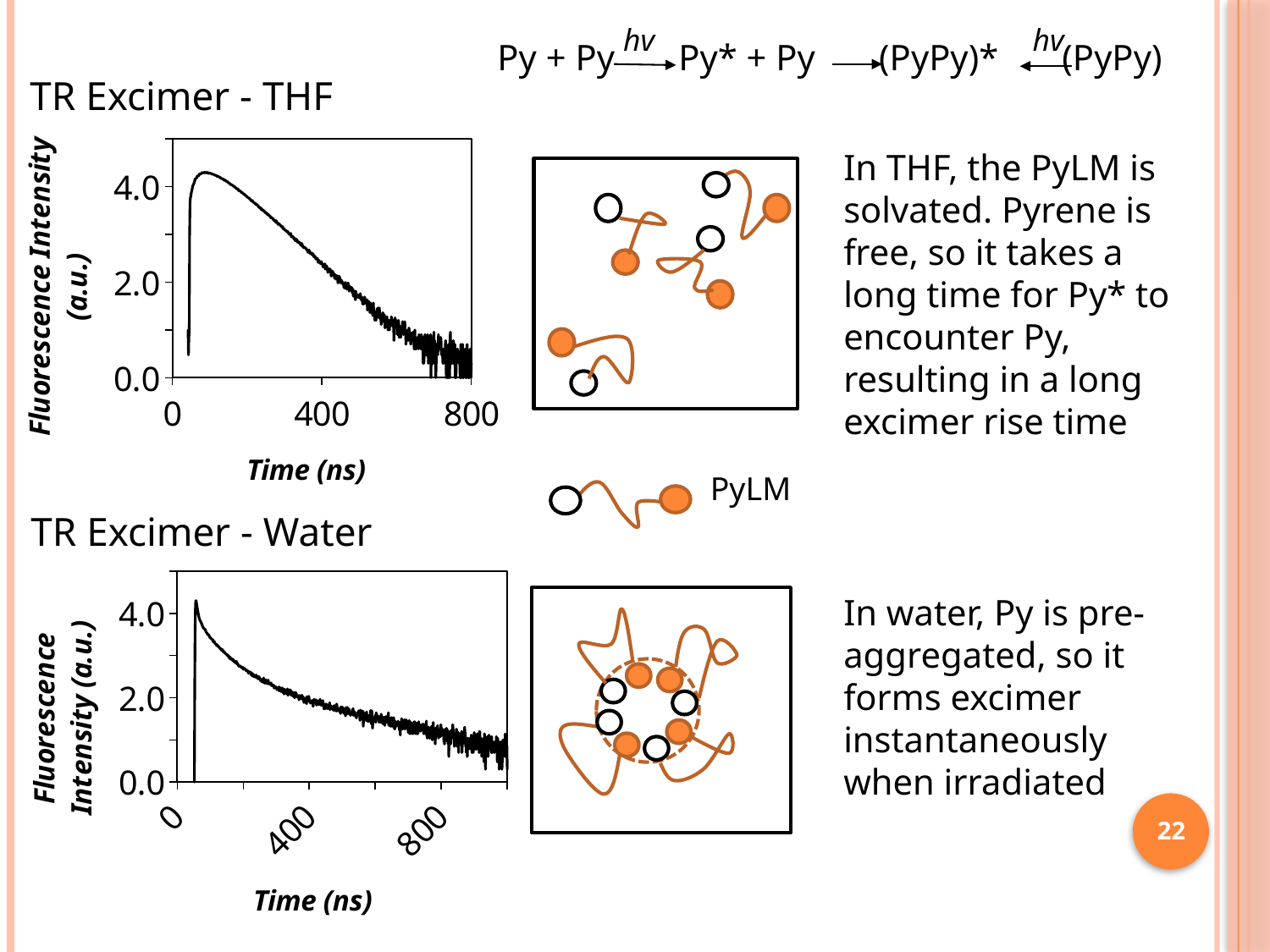
In the TR Excimer - THF chart, is the peak fluorescence intensity greater or less than 2.0? greater What is the x-axis label of the TR Excimer - Water chart? Time (ns) In the TR Excimer - Water chart, is the peak fluorescence intensity greater or less than 2.0? greater In the TR Excimer - THF chart, is the fluorescence intensity at 800 ns greater or less than 2.0? less How many data series are plotted in the TR Excimer - Water chart? 1 What is the y-axis label of the TR Excimer - THF chart? Fluorescence Intensity (a.u.) What is the largest tick value shown on the x axis of the TR Excimer - THF chart? 800 In the TR Excimer - THF chart, after the curve reaches its peak, does the fluorescence intensity rise or fall as time increases? fall In the TR Excimer - Water chart, after the initial peak, does the fluorescence intensity rise or fall as time increases? fall What kind of chart is the TR Excimer - Water chart? line chart What kind of chart is the TR Excimer - THF chart? line chart